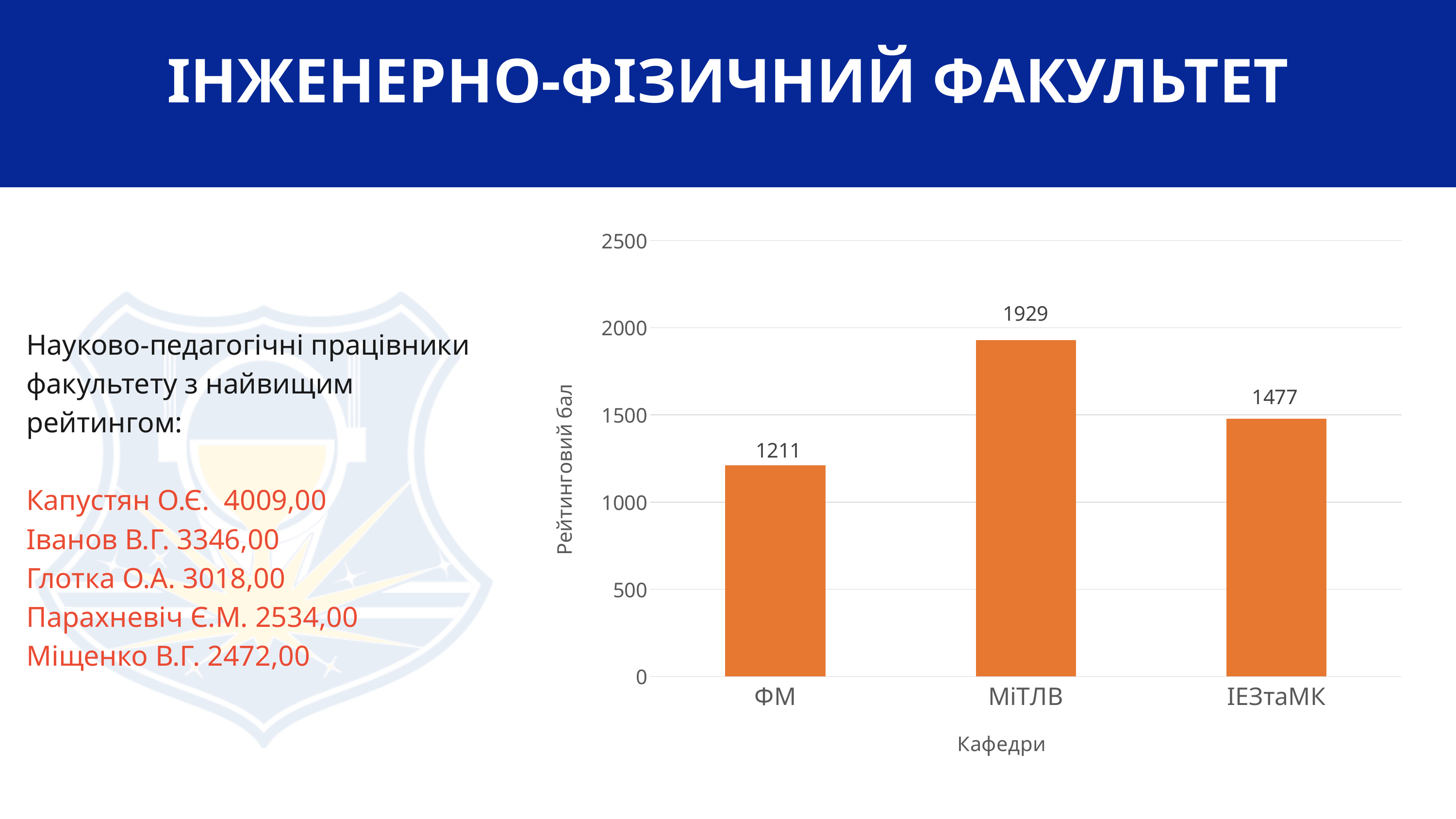
How many departments are shown on the chart? 3 What is the label of the x axis of the chart? Кафедри Is the rating score for МіТЛВ greater or less than 2000? less What type of chart is shown on the slide? bar chart Which has a higher rating score, ІЕЗтаМК or ФМ? ІЕЗтаМК What is the rating score for the МіТЛВ department? 1929 What is the rating score for the ІЕЗтаМК department? 1477 What is the difference between the rating scores of ІЕЗтаМК and ФМ? 266 Which department has the highest rating score? МіТЛВ What is the rating score (Рейтинговий бал) for the ФМ department? 1211 Which department has the lowest rating score? ФМ What is the difference between the rating scores of МіТЛВ and ФМ? 718